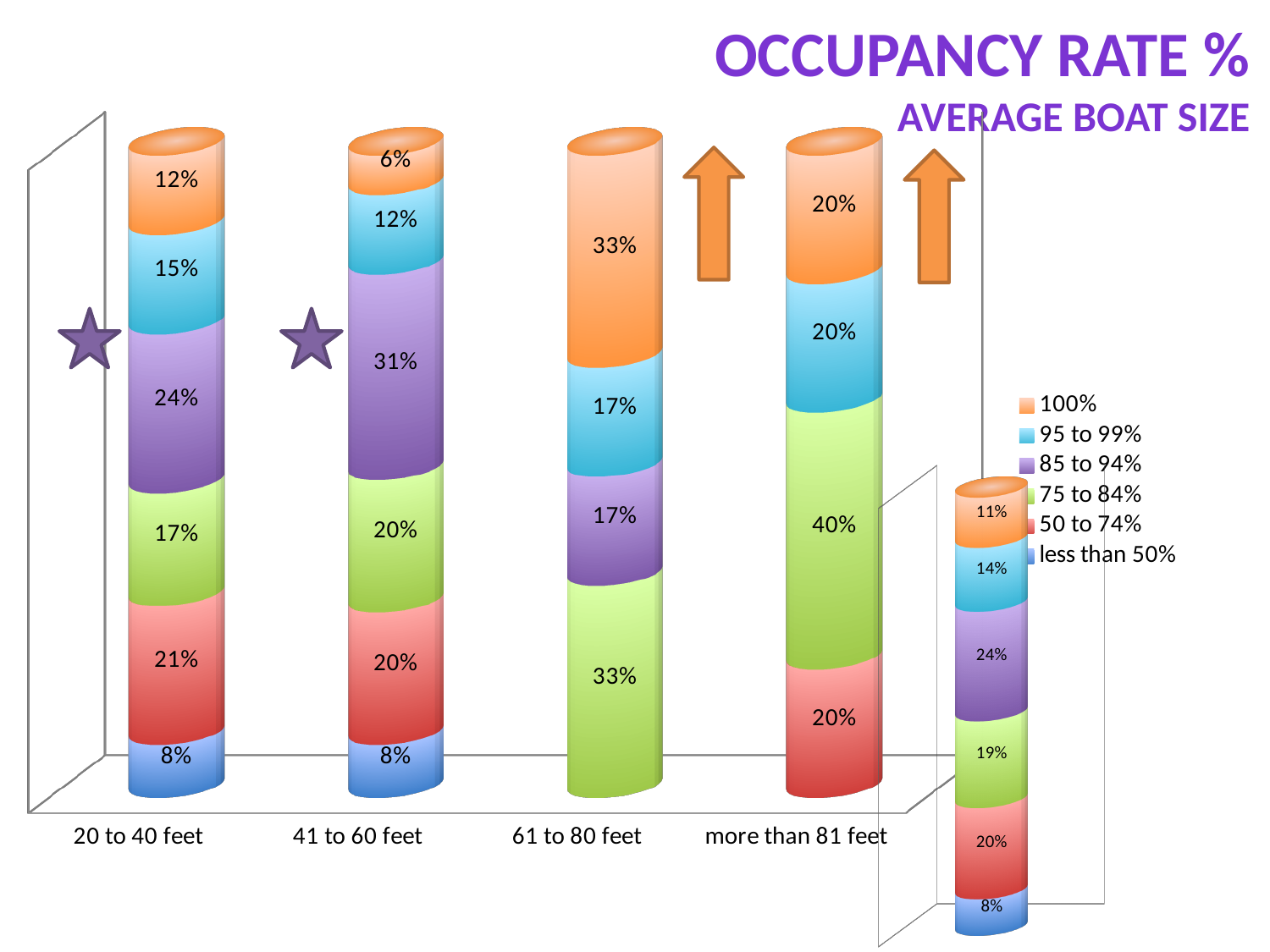
In the main chart, what is the difference between the 85 to 94% values for 41 to 60 feet and 20 to 40 feet? 7% In the main chart, what is the value of the 85 to 94% series for 20 to 40 feet? 24% What kind of chart is the main chart? Stacked bar chart In the main chart, which series has the largest value in the 41 to 60 feet bar? 85 to 94% In the small chart on the right, what is the value of the 85 to 94% series? 24% In the main chart, what is the value of the 100% series for 41 to 60 feet? 6% In the main chart, what is the value of the 75 to 84% series for more than 81 feet? 40% In the main chart, which series has the smallest value in the 20 to 40 feet bar? less than 50% In the main chart, what is the value of the 50 to 74% series for 20 to 40 feet? 21% How many series does the legend list? 6 In the main chart, which is larger: the 100% value for 61 to 80 feet or the 100% value for more than 81 feet? 61 to 80 feet How many boat size categories are shown on the x axis of the main chart? 4